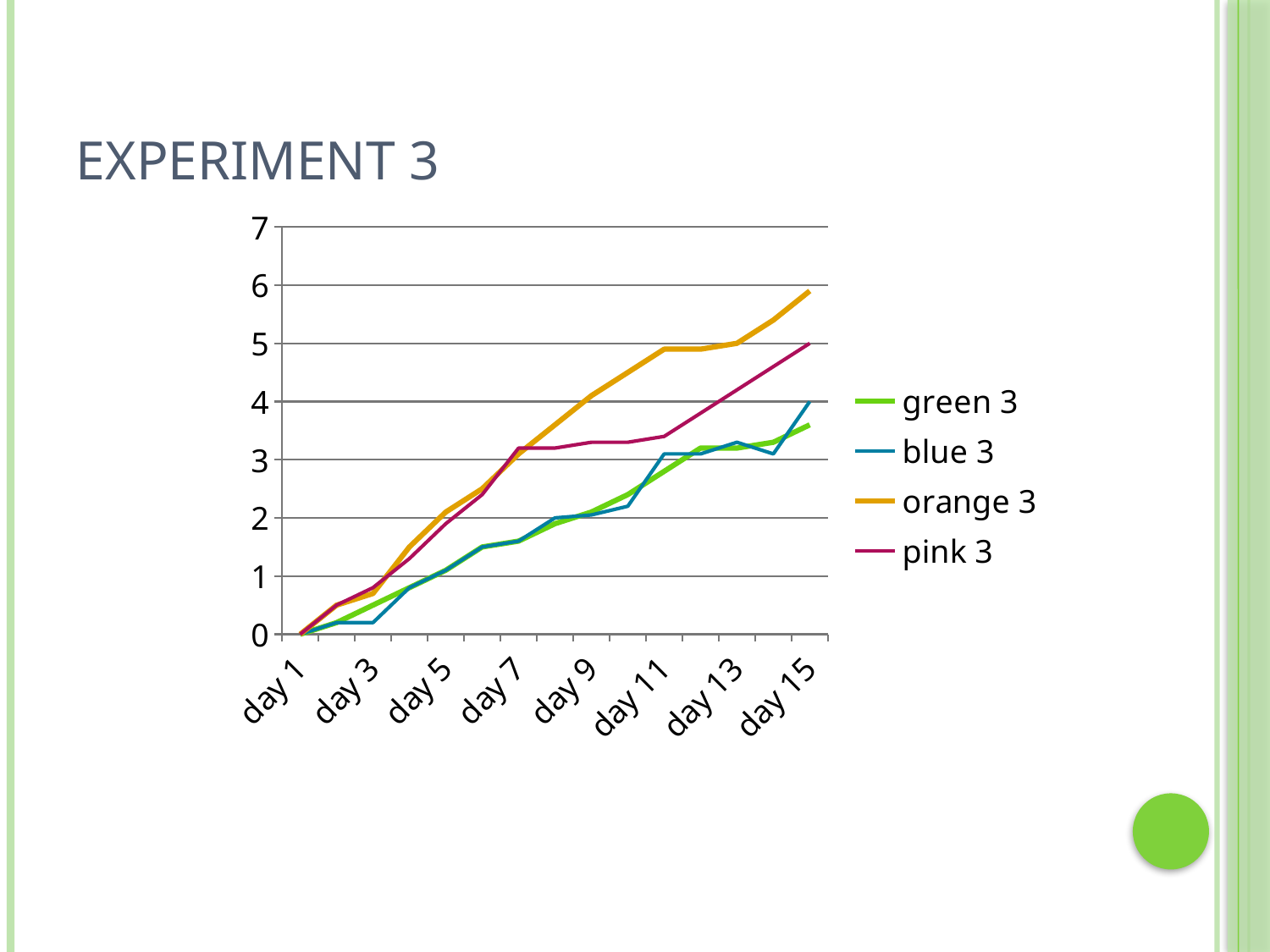
Which series has the highest value at day 15? orange 3 Which series has the lowest value at day 15? green 3 What is the value of blue 3 at day 15? 4 How many series does the legend list? 4 Is the value for pink 3 at day 11 greater or less than 4? less Do the values of orange 3 generally rise or fall from day 1 to day 15? rise What is the value of pink 3 at day 15? 5 What is the title of the slide containing the chart? EXPERIMENT 3 At day 13, which is larger: orange 3 or pink 3? orange 3 Is the value for orange 3 at day 15 greater or less than 5? greater What kind of chart is shown on the slide? line chart Which series are listed in the legend? green 3, blue 3, orange 3, pink 3